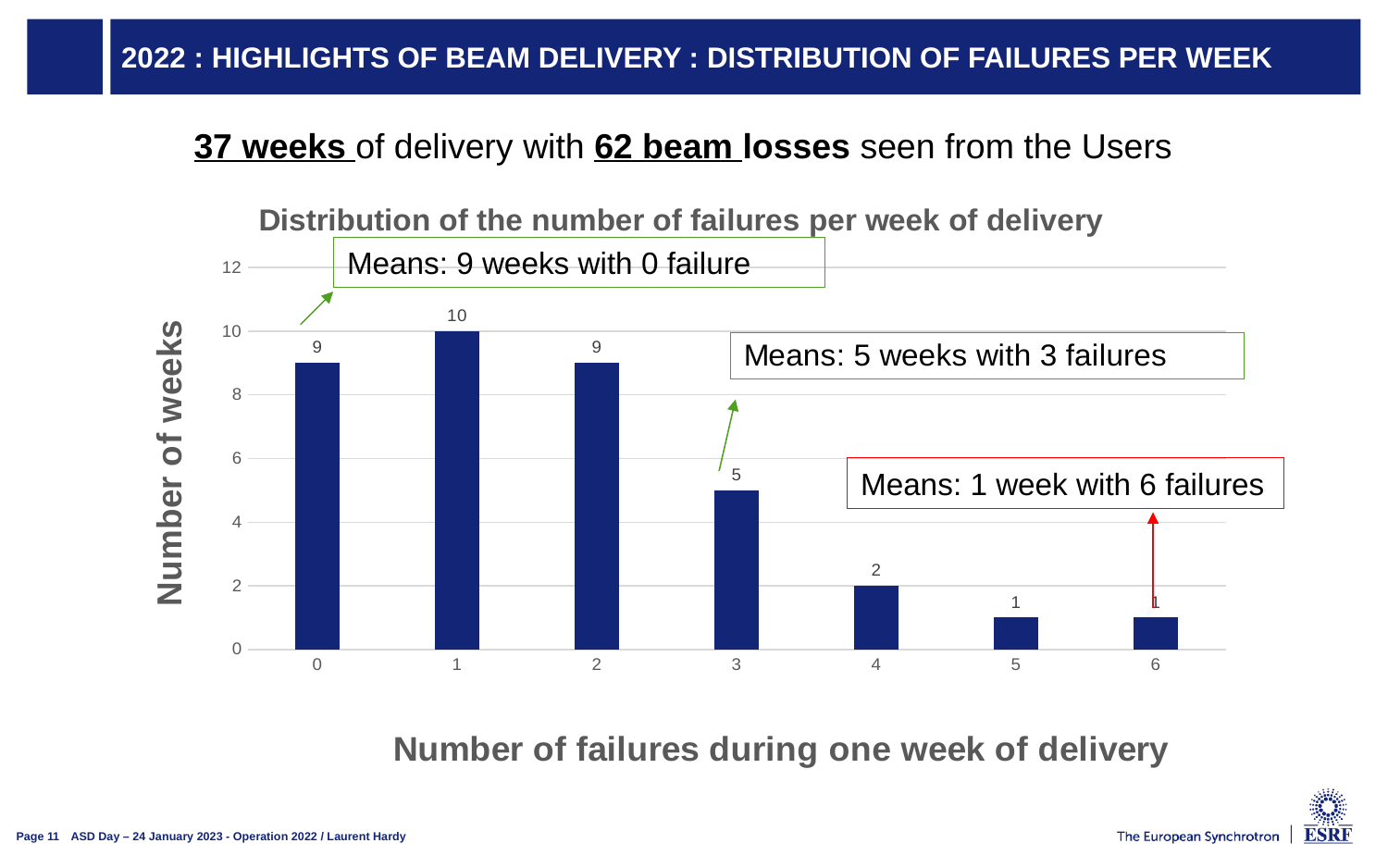
Do the values generally rise or fall as the number of failures increases from 1 to 6? fall What type of chart is shown on the slide? bar chart What is the difference between the number of weeks with 1 failure and the number of weeks with 3 failures? 5 Which number of failures per week corresponds to the highest number of weeks? 1 What is the label of the y axis? Number of weeks What is the difference between the number of weeks with 0 failures and the number of weeks with 6 failures? 8 Which has more weeks: 2 failures or 4 failures? 2 failures How many weeks had 4 failures? 2 How many weeks had 3 failures? 5 How many categories are shown on the x axis? 7 What is the chart's title? Distribution of the number of failures per week of delivery How many weeks had 1 failure? 10